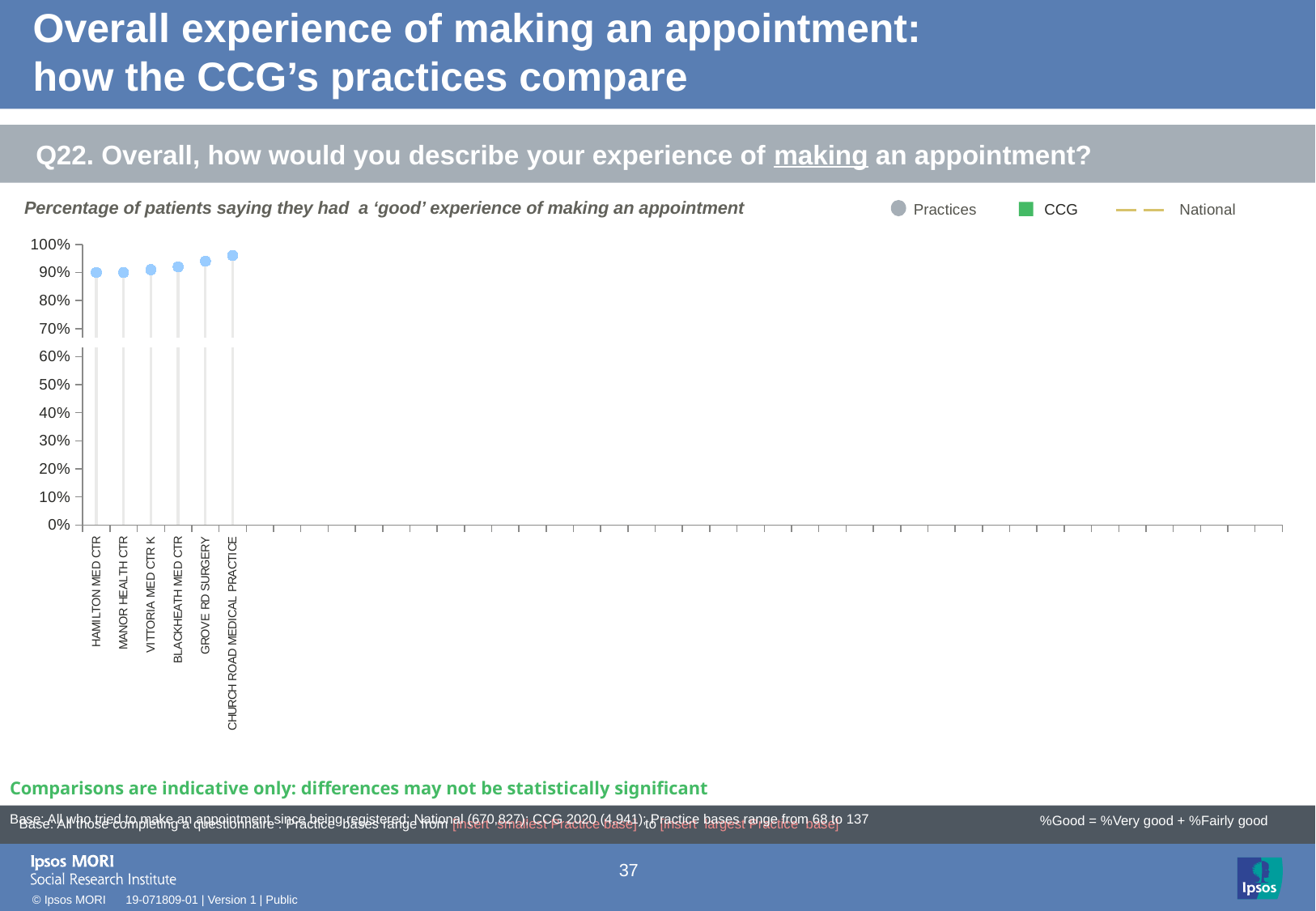
Which has a higher value, GROVE RD SURGERY or MANOR HEALTH CTR? GROVE RD SURGERY Is the value for HAMILTON MED CTR greater or less than 80%? greater How many practices are plotted on the chart? 6 Is the value for VITTORIA MED CTR K greater or less than 100%? less How many entries does the chart legend list? 3 Which has a higher value, CHURCH ROAD MEDICAL PRACTICE or HAMILTON MED CTR? CHURCH ROAD MEDICAL PRACTICE What is the first practice listed on the x axis? HAMILTON MED CTR Is the value for CHURCH ROAD MEDICAL PRACTICE greater or less than 90%? greater Do the plotted values rise or fall moving from left to right along the x axis? rise Which practice has the highest percentage of patients saying they had a 'good' experience of making an appointment? CHURCH ROAD MEDICAL PRACTICE What does the chart's subtitle say is being measured? Percentage of patients saying they had a 'good' experience of making an appointment